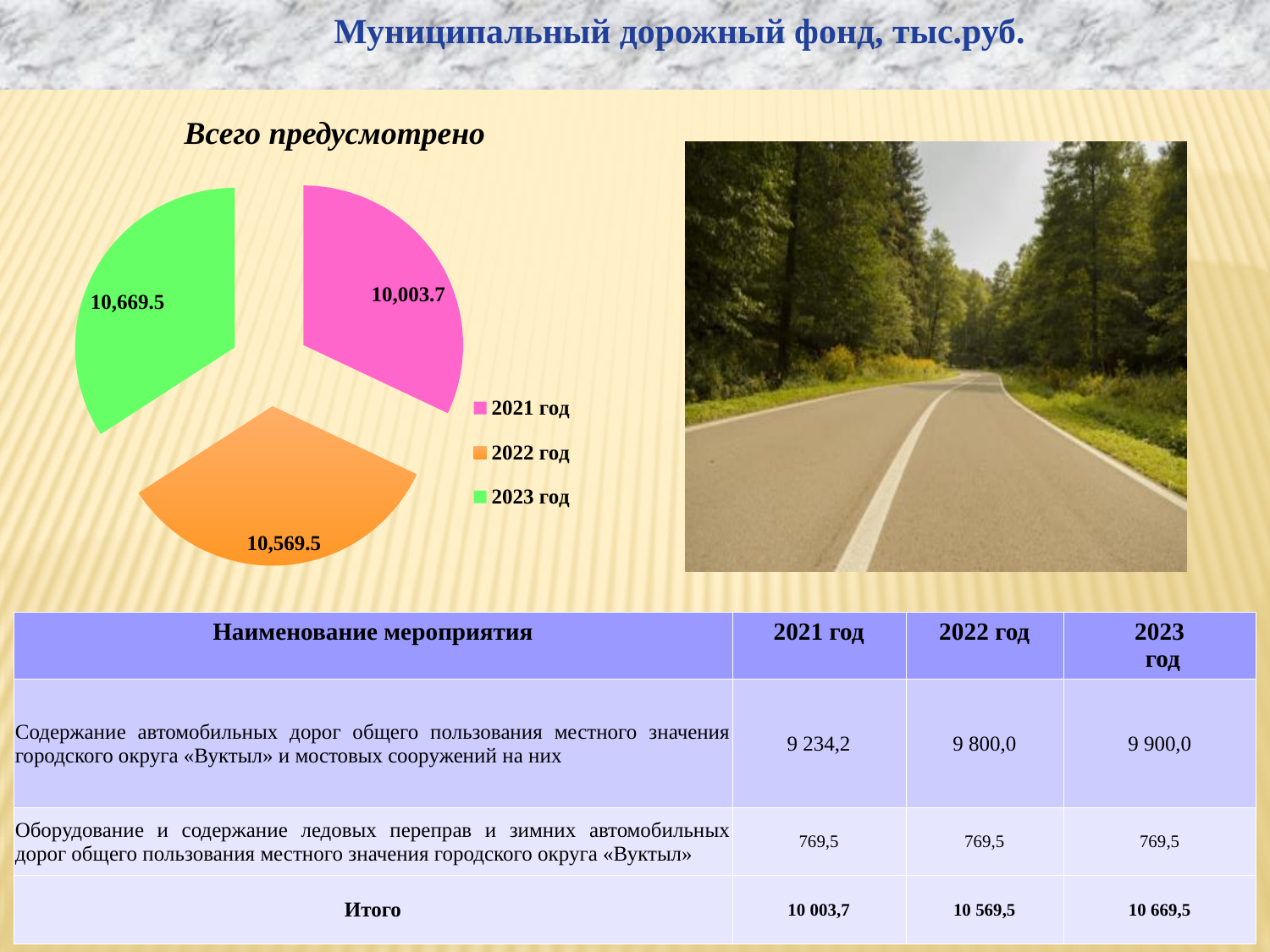
In the pie chart, what is the difference between the values for 2023 год and 2022 год? 100.0 Which year has the smallest slice in the pie chart? 2021 год What colour is the slice for 2022 год in the pie chart? orange In the pie chart, what is the value for 2023 год? 10,669.5 How many slices does the pie chart have? 3 What type of chart is shown under the heading "Всего предусмотрено"? pie chart In the pie chart, what is the difference between the values for 2023 год and 2021 год? 665.8 Do the values in the pie chart rise or fall from 2021 год to 2023 год? rise Which year has the largest slice in the pie chart? 2023 год In the pie chart, which is larger: the value for 2022 год or the value for 2021 год? 2022 год In the pie chart, what is the value for 2021 год? 10,003.7 In the pie chart, what is the value for 2022 год? 10,569.5